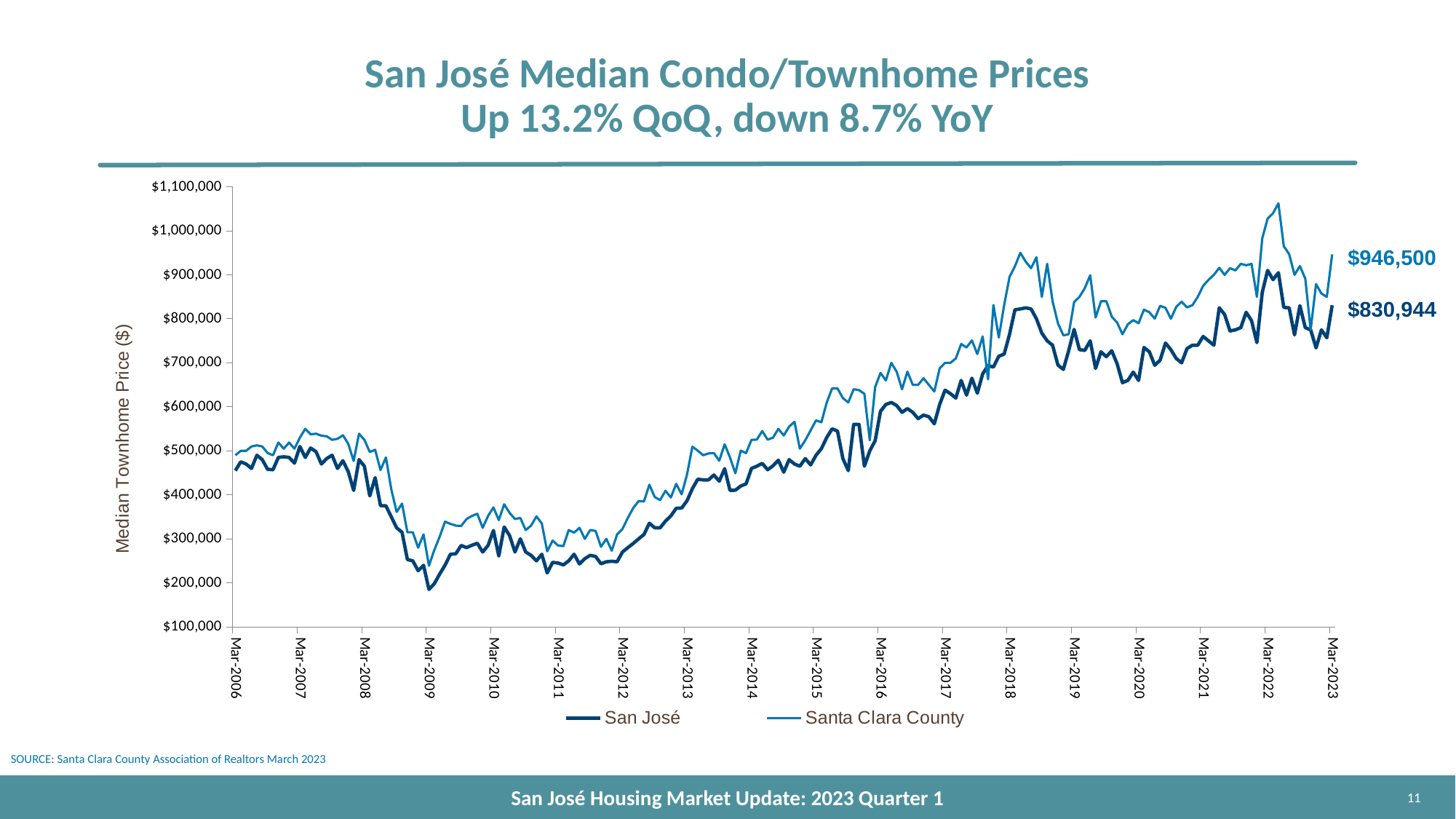
Around which year does the San José line reach its lowest point? 2009 Is the peak Santa Clara County value in 2022 greater or less than $1,000,000? greater What is the difference between the Santa Clara County and San José values labeled at Mar-2023? $115,556 At Mar-2023, which series has the higher labeled value, San José or Santa Clara County? Santa Clara County Does the San José line generally rise or fall between Mar-2012 and Mar-2018? rise Is the San José value around Mar-2009 greater or less than $200,000? less What is the label on the vertical axis? Median Townhome Price ($) What is the labeled value for San José at the end of the series (Mar-2023)? $830,944 What is the labeled value for Santa Clara County at the end of the series (Mar-2023)? $946,500 What kind of chart is shown on the slide? line chart Which series is drawn with the thicker, darker line? San José How many series does the legend list? 2